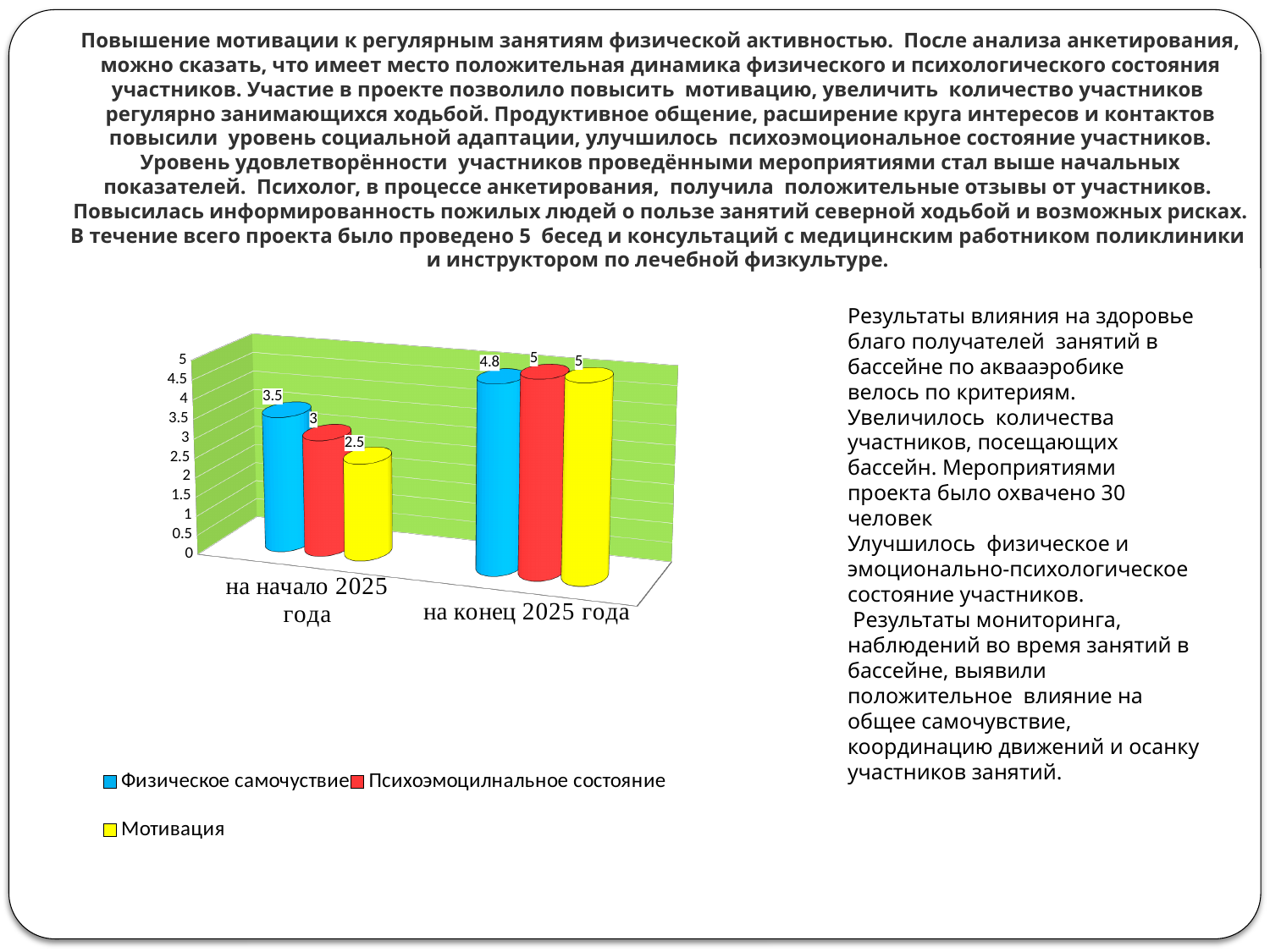
How many series does the chart legend list? 3 What is the value for Психоэмоцилнальное состояние at на начало 2025 года? 3 What is the value for Физическое самочуствие at на конец 2025 года? 4.8 Which series has the lowest value at на начало 2025 года? Мотивация What is the value for Физическое самочуствие at на начало 2025 года? 3.5 What kind of chart is shown on the slide? Bar chart What is the difference between the Мотивация values at на конец 2025 года and на начало 2025 года? 2.5 What is the value for Мотивация at на конец 2025 года? 5 Which series has the highest value at на начало 2025 года? Физическое самочуствие How many categories are shown on the x axis of the chart? 2 Do the values for Психоэмоцилнальное состояние rise or fall from на начало 2025 года to на конец 2025 года? Rise Which is larger: Физическое самочуствие at на начало 2025 года or Психоэмоцилнальное состояние at на начало 2025 года? Физическое самочуствие at на начало 2025 года